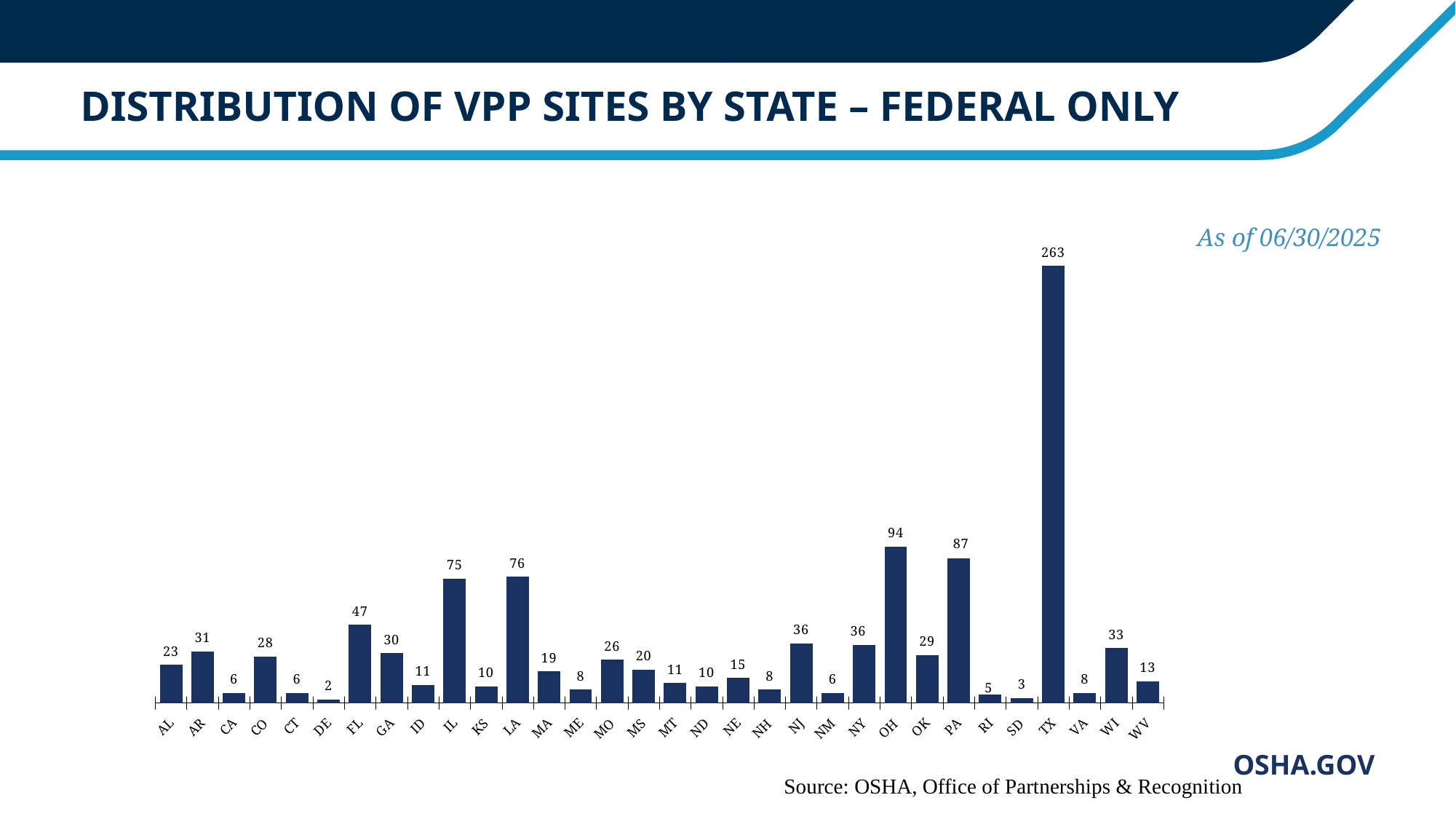
Which is larger, the value for AR or the value for WI? WI What is the difference between the values for TX and OH? 169 What is the value for OH? 94 What is the value for FL? 47 Which state has the lowest value? DE Which is larger, the value for IL or the value for LA? LA Which state has the highest value? TX What is the value for TX? 263 What kind of chart is shown on the slide? Bar chart What is the difference between the values for PA and OH? 7 What is the 'as of' date shown on the slide? 06/30/2025 How many states are shown on the x axis? 32